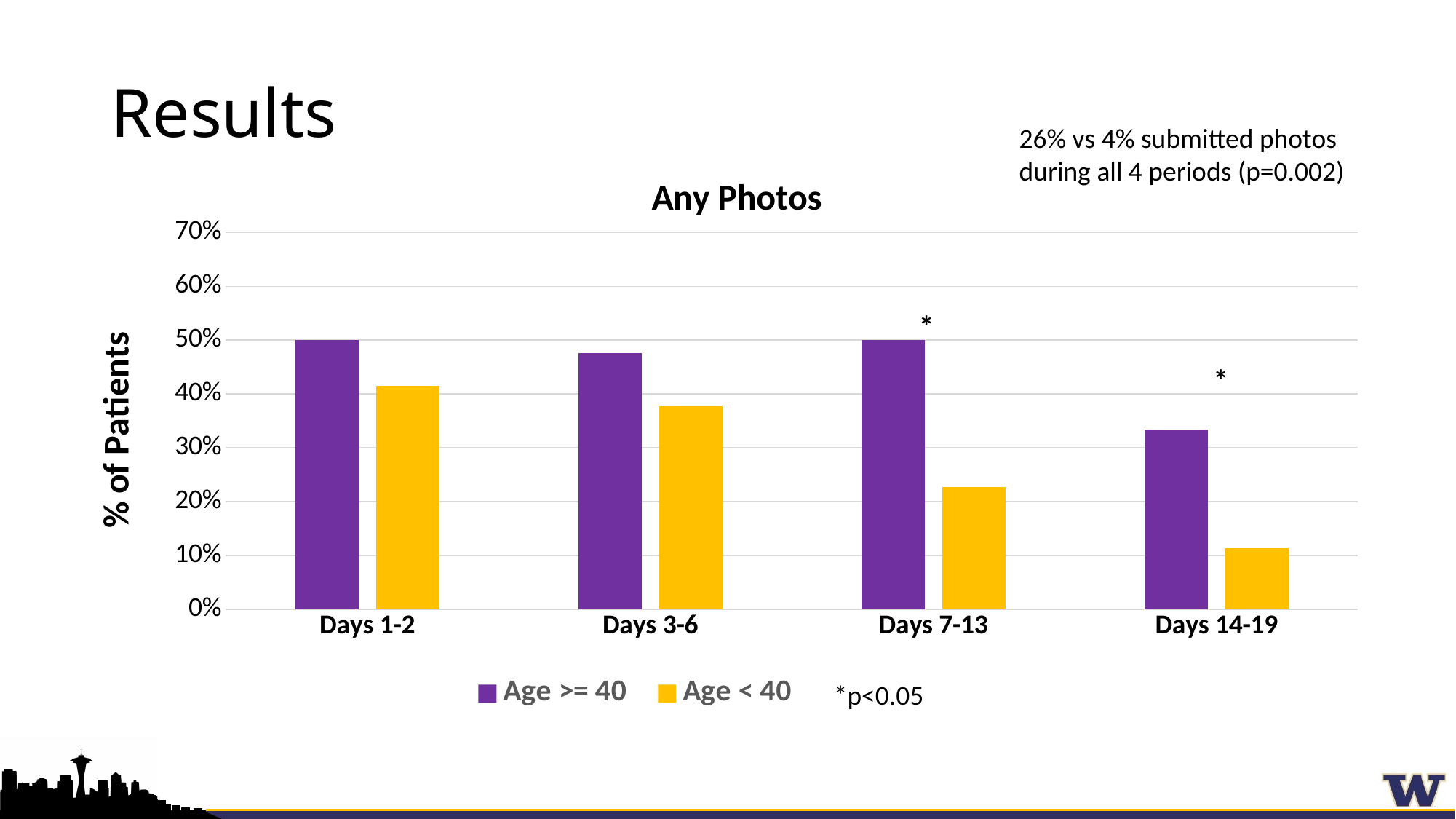
Is the value for Age < 40 in Days 7-13 greater or less than 30%? less What kind of chart is shown on the slide? bar chart Which category has the lowest value for the Age >= 40 series? Days 14-19 How many series does the legend list? 2 Which category has the highest value for the Age < 40 series? Days 1-2 Is the value for Age < 40 in Days 14-19 greater or less than 20%? less Is the value for Age >= 40 in Days 3-6 greater or less than 40%? greater What is the title of the chart? Any Photos Which category has the lowest value for the Age < 40 series? Days 14-19 How many time-period categories are shown on the x axis? 4 In Days 7-13, which series has the larger value, Age >= 40 or Age < 40? Age >= 40 Do the values for the Age < 40 series rise or fall from Days 1-2 to Days 14-19? fall